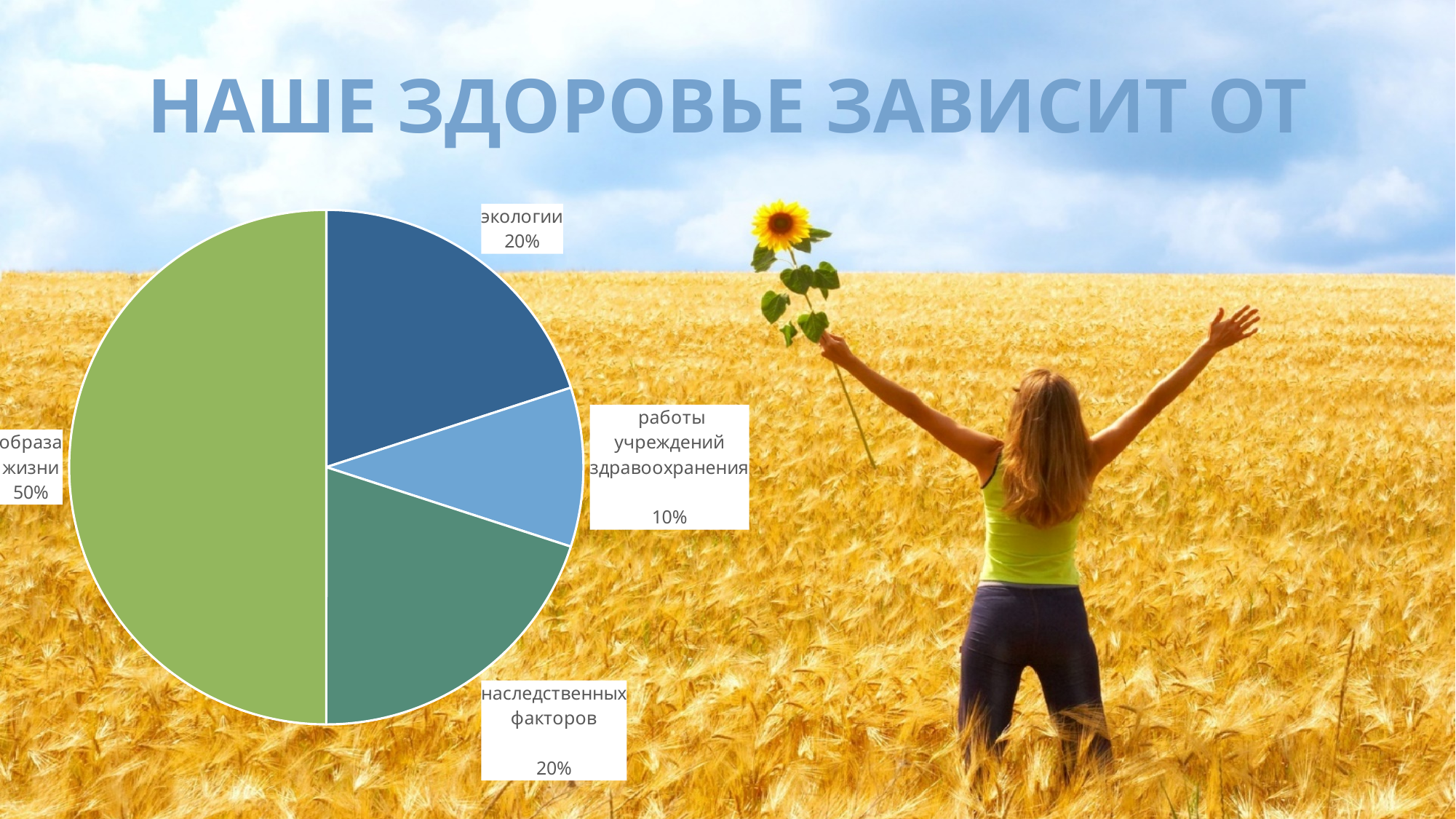
How many slices does the pie chart have? 4 What kind of chart is shown on the slide? pie chart What is the difference between the share for образа жизни and the share for экологии? 30% Which category has the smallest share of the pie? работы учреждений здравоохранения What is the title of the slide? НАШЕ ЗДОРОВЬЕ ЗАВИСИТ ОТ What percentage is shown for образа жизни? 50% What percentage is shown for наследственных факторов? 20% What percentage is shown for экологии? 20% What percentage is shown for работы учреждений здравоохранения? 10% What colour is the slice for образа жизни? green Which category has the largest share of the pie? образа жизни Which is larger, the share for наследственных факторов or the share for работы учреждений здравоохранения? наследственных факторов